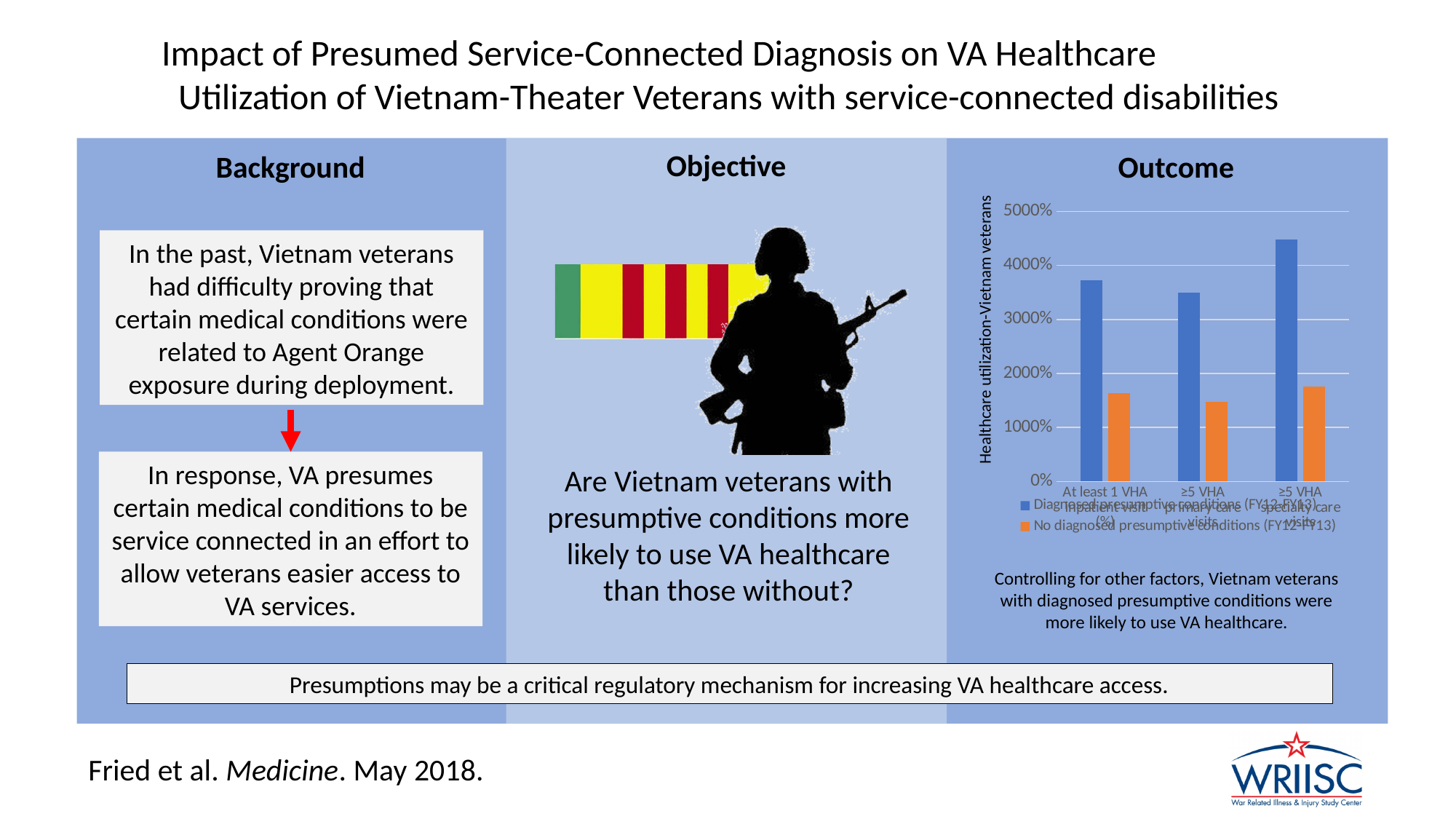
What is the y-axis title of the Outcome chart? Healthcare utilization-Vietnam veterans In the Outcome chart, which category has the highest value for the Diagnosed presumptive conditions (FY12-FY13) series? ≥5 VHA specialty care visits In the Outcome chart, is the No diagnosed presumptive conditions value for ≥5 VHA primary care visits greater or less than 2000%? less In the Outcome chart, for At least 1 VHA inpatient visit, which series has the smaller value: Diagnosed presumptive conditions or No diagnosed presumptive conditions? No diagnosed presumptive conditions (FY12-FY13) In the Outcome chart, is the No diagnosed presumptive conditions value for At least 1 VHA inpatient visit greater or less than 1000%? greater How many series does the legend of the Outcome chart list? 2 In the Outcome chart, is the Diagnosed presumptive conditions value for ≥5 VHA specialty care visits greater or less than 4000%? greater In the Outcome chart, for ≥5 VHA specialty care visits, which series has the larger value: Diagnosed presumptive conditions or No diagnosed presumptive conditions? Diagnosed presumptive conditions (FY12-FY13) How many categories are shown on the x axis of the Outcome chart? 3 What kind of chart is shown in the Outcome panel? bar chart In the Outcome chart, which category has the lowest value for the Diagnosed presumptive conditions (FY12-FY13) series? ≥5 VHA primary care visits